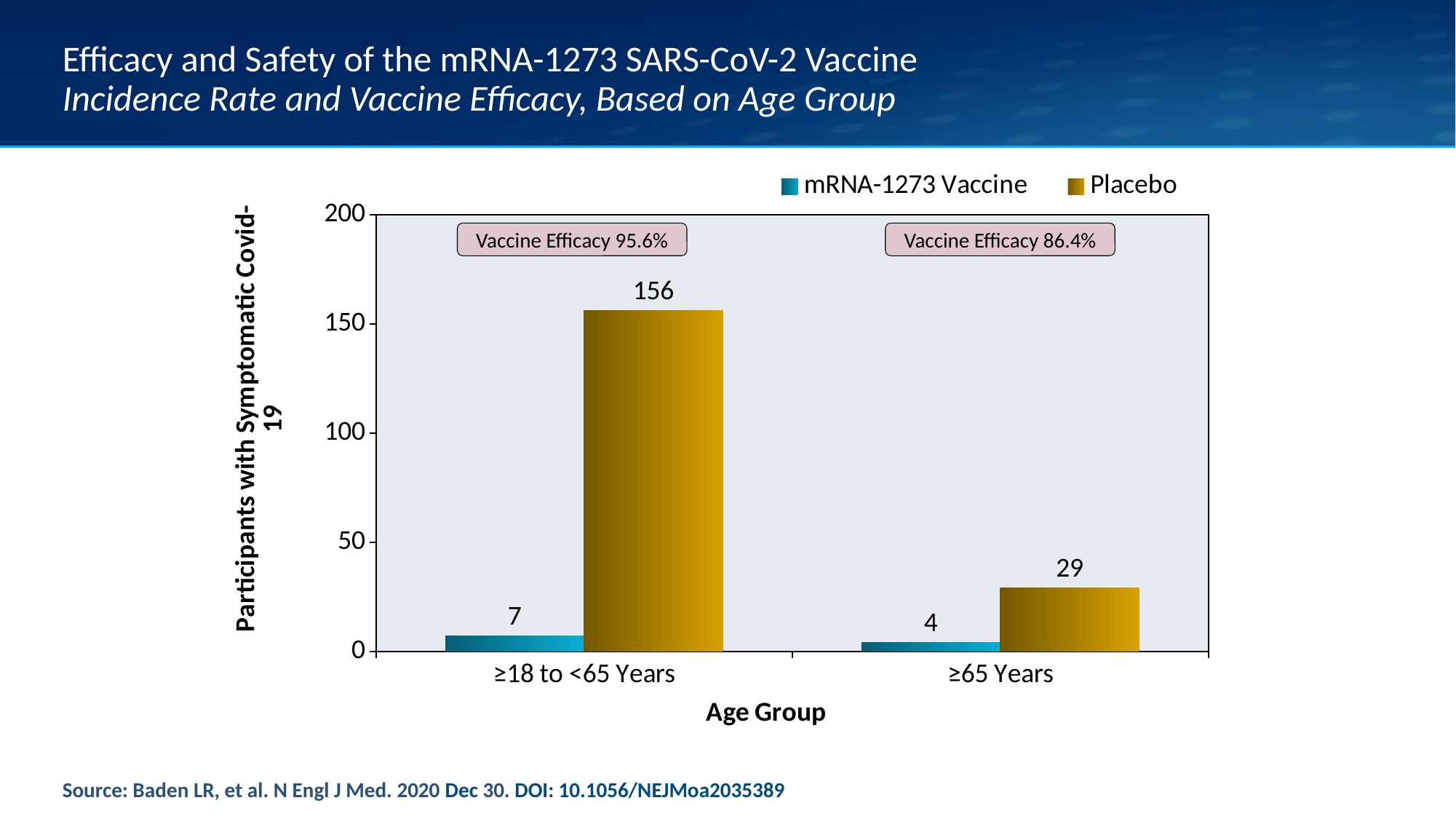
How many age groups are shown on the x axis? 2 Which bar shows the lowest number of participants with symptomatic Covid-19? mRNA-1273 Vaccine, ≥65 Years How many series does the legend list? 2 Which bar shows the highest number of participants with symptomatic Covid-19? Placebo, ≥18 to <65 Years What is the difference between the Placebo and mRNA-1273 Vaccine values in the ≥65 Years age group? 25 What is the difference between the Placebo and mRNA-1273 Vaccine values in the ≥18 to <65 Years age group? 149 What is the value for the mRNA-1273 Vaccine group in the ≥18 to <65 Years age group? 7 How many participants with symptomatic Covid-19 were in the Placebo group for the ≥18 to <65 Years age group? 156 What is the value for the Placebo group in the ≥65 Years age group? 29 What is the vaccine efficacy shown for the ≥65 Years age group? 86.4% Which is larger: the Placebo value for ≥65 Years or the mRNA-1273 Vaccine value for ≥18 to <65 Years? Placebo value for ≥65 Years How many participants with symptomatic Covid-19 were in the mRNA-1273 Vaccine group for the ≥65 Years age group? 4